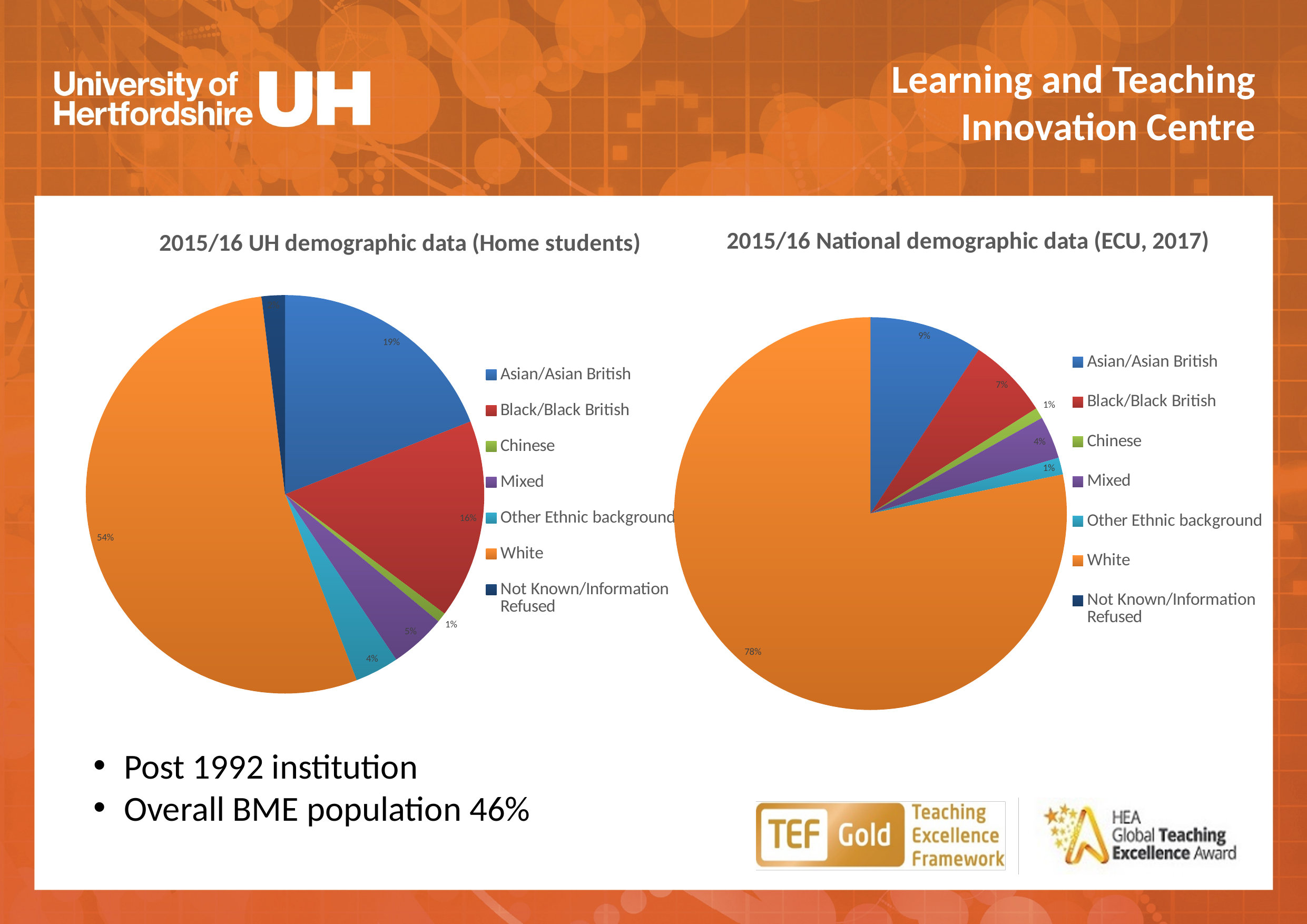
In the '2015/16 National demographic data (ECU, 2017)' chart, what percentage is shown for Mixed? 4% In the '2015/16 National demographic data (ECU, 2017)' chart, what percentage is shown for Asian/Asian British? 9% In the '2015/16 National demographic data (ECU, 2017)' chart, what percentage is shown for White? 78% In the '2015/16 UH demographic data (Home students)' chart, what percentage is shown for Asian/Asian British? 19% In the '2015/16 UH demographic data (Home students)' chart, which is larger: Asian/Asian British or Black/Black British? Asian/Asian British How many categories does the legend of the '2015/16 National demographic data (ECU, 2017)' chart list? 7 In the '2015/16 National demographic data (ECU, 2017)' chart, which category has the largest slice? White What type of chart is used for the '2015/16 UH demographic data (Home students)'? Pie chart In the '2015/16 UH demographic data (Home students)' chart, what percentage is shown for White? 54% In the '2015/16 UH demographic data (Home students)' chart, what percentage is shown for Black/Black British? 16% In the '2015/16 UH demographic data (Home students)' chart, which category has the largest slice? White What is the difference between the White share in the National chart (78%) and the White share in the UH chart (54%)? 24 percentage points